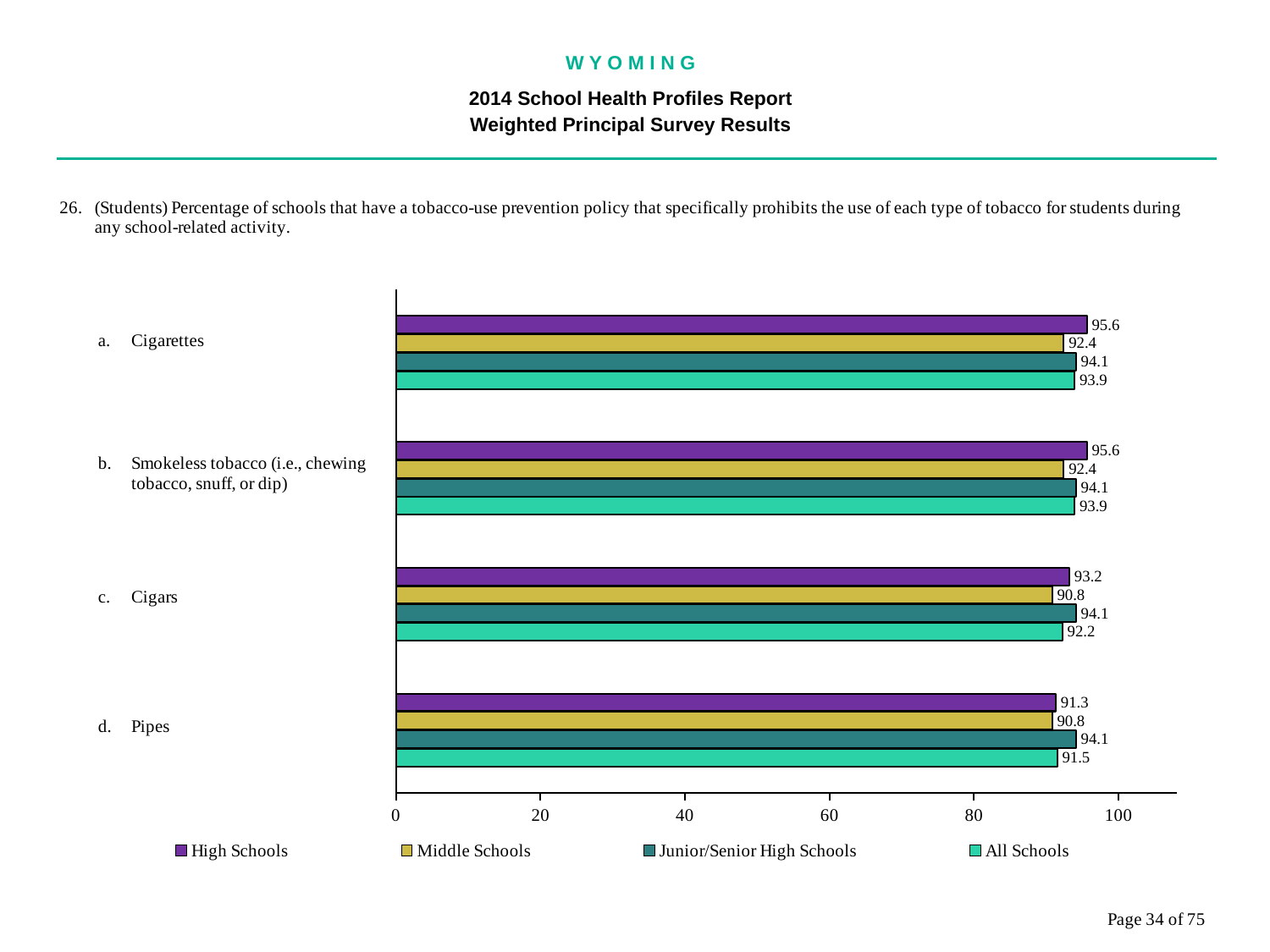
Which is larger for Pipes: the Junior/Senior High Schools value or the High Schools value? Junior/Senior High Schools What is the value for All Schools for Pipes? 91.5 What is the value for High Schools for Cigarettes? 95.6 What is the value for Junior/Senior High Schools for Smokeless tobacco? 94.1 How many series does the legend list? 4 Which series is shown in purple in the legend? High Schools Is the value for Middle Schools for Pipes greater or less than 80? greater What kind of chart is shown on the slide? bar chart Which category has the lowest value for High Schools? Pipes How many categories are shown on the chart? 4 What is the difference between the High Schools value and the Middle Schools value for Cigarettes? 3.2 What is the value for Middle Schools for Cigars? 90.8